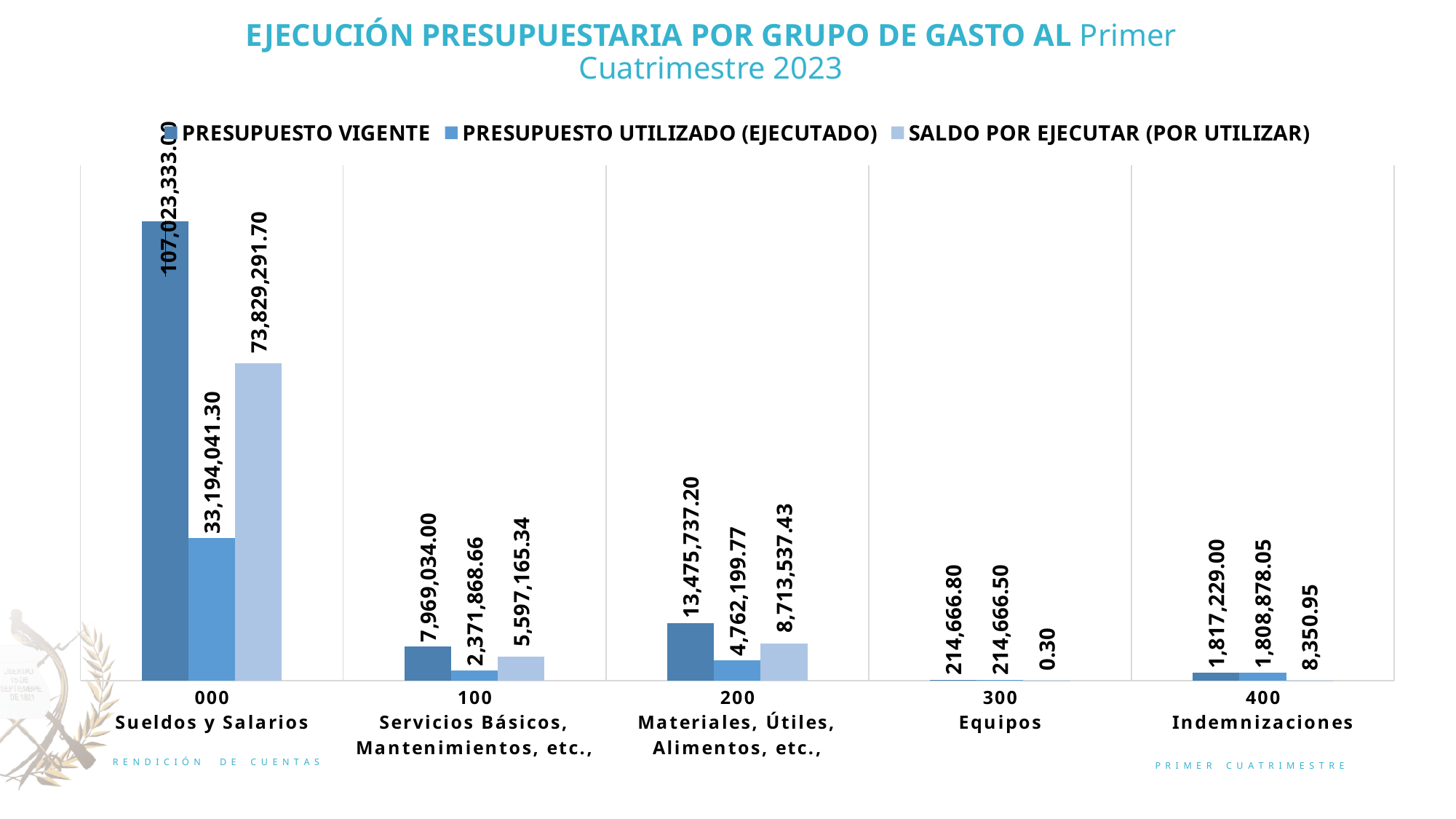
Which category has the highest PRESUPUESTO UTILIZADO (EJECUTADO) value? 000 Sueldos y Salarios Which category has the lowest SALDO POR EJECUTAR (POR UTILIZAR) value? 300 Equipos What is the PRESUPUESTO VIGENTE value for 100 Servicios Básicos, Mantenimientos, etc.? 7,969,034.00 What is the difference between the PRESUPUESTO VIGENTE values for 200 Materiales, Útiles, Alimentos, etc. and 100 Servicios Básicos, Mantenimientos, etc.? 5,506,703.20 What is the difference between the SALDO POR EJECUTAR (POR UTILIZAR) values for 200 Materiales, Útiles, Alimentos, etc. and 100 Servicios Básicos, Mantenimientos, etc.? 3,116,372.09 How many series does the legend list? 3 What is the PRESUPUESTO UTILIZADO (EJECUTADO) value for 400 Indemnizaciones? 1,808,878.05 What is the PRESUPUESTO UTILIZADO (EJECUTADO) value for 000 Sueldos y Salarios? 33,194,041.30 What is the SALDO POR EJECUTAR (POR UTILIZAR) value for 200 Materiales, Útiles, Alimentos, etc.? 8,713,537.43 What is the SALDO POR EJECUTAR (POR UTILIZAR) value for 300 Equipos? 0.30 How many expense group categories are shown on the x axis? 5 Which is larger: the PRESUPUESTO UTILIZADO (EJECUTADO) value for 200 Materiales, Útiles, Alimentos, etc. or for 100 Servicios Básicos, Mantenimientos, etc.? 200 Materiales, Útiles, Alimentos, etc.